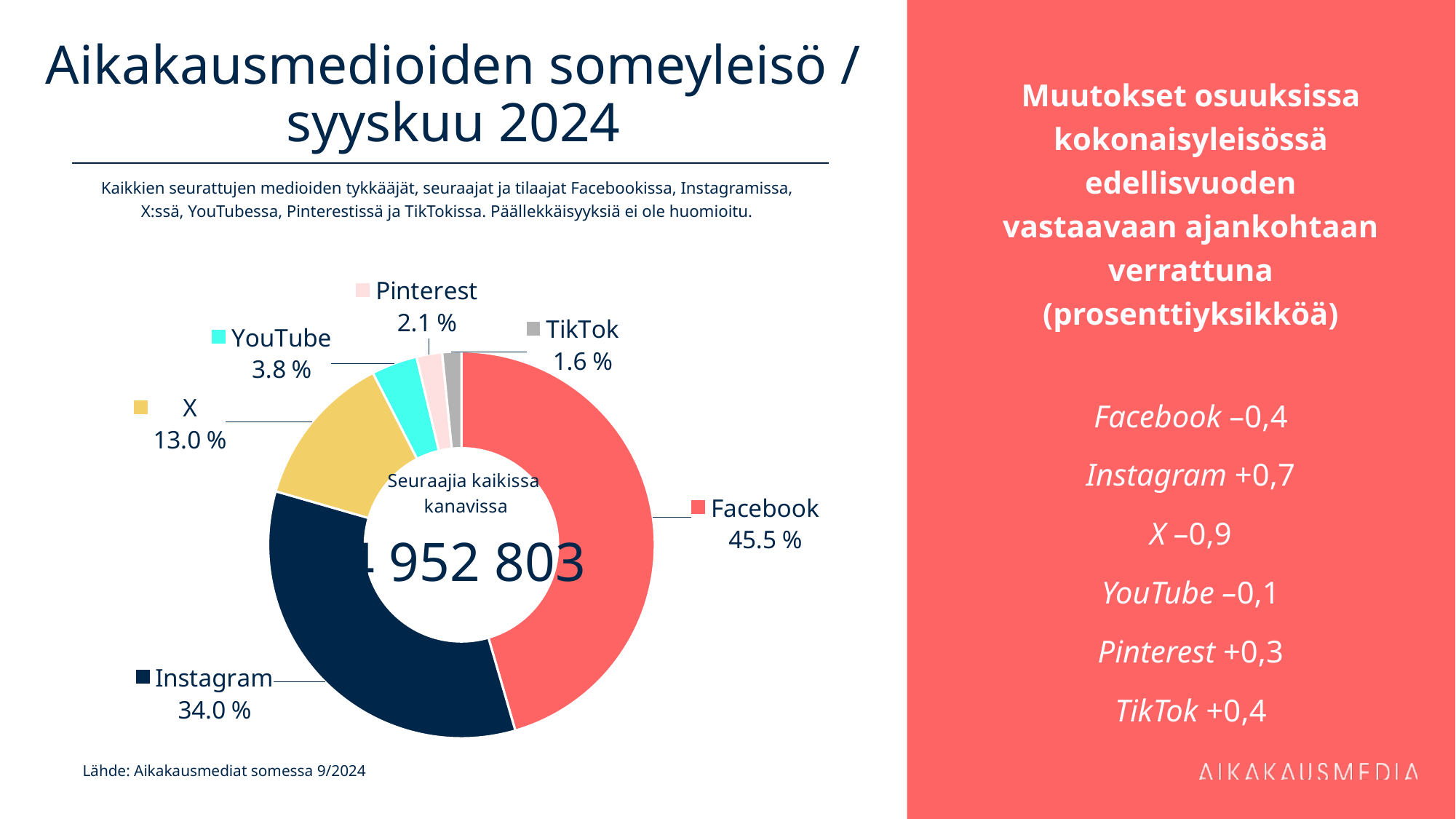
What is the difference in percentage points between Facebook's and Instagram's shares? 11.5 Which platform has the largest share in the chart? Facebook What share does Instagram have in the chart? 34.0 % Which has a larger share, YouTube or Pinterest? YouTube What share of the social media audience does Facebook have? 45.5 % What share does TikTok have in the chart? 1.6 % What is the share for X in the chart? 13.0 % How many platforms are shown in the chart? 6 What kind of chart is shown on the slide? Pie chart (donut) Which platform has the smallest share in the chart? TikTok What colour is the Instagram slice in the chart? Dark navy blue What is the combined share of YouTube and Pinterest? 5.9 %